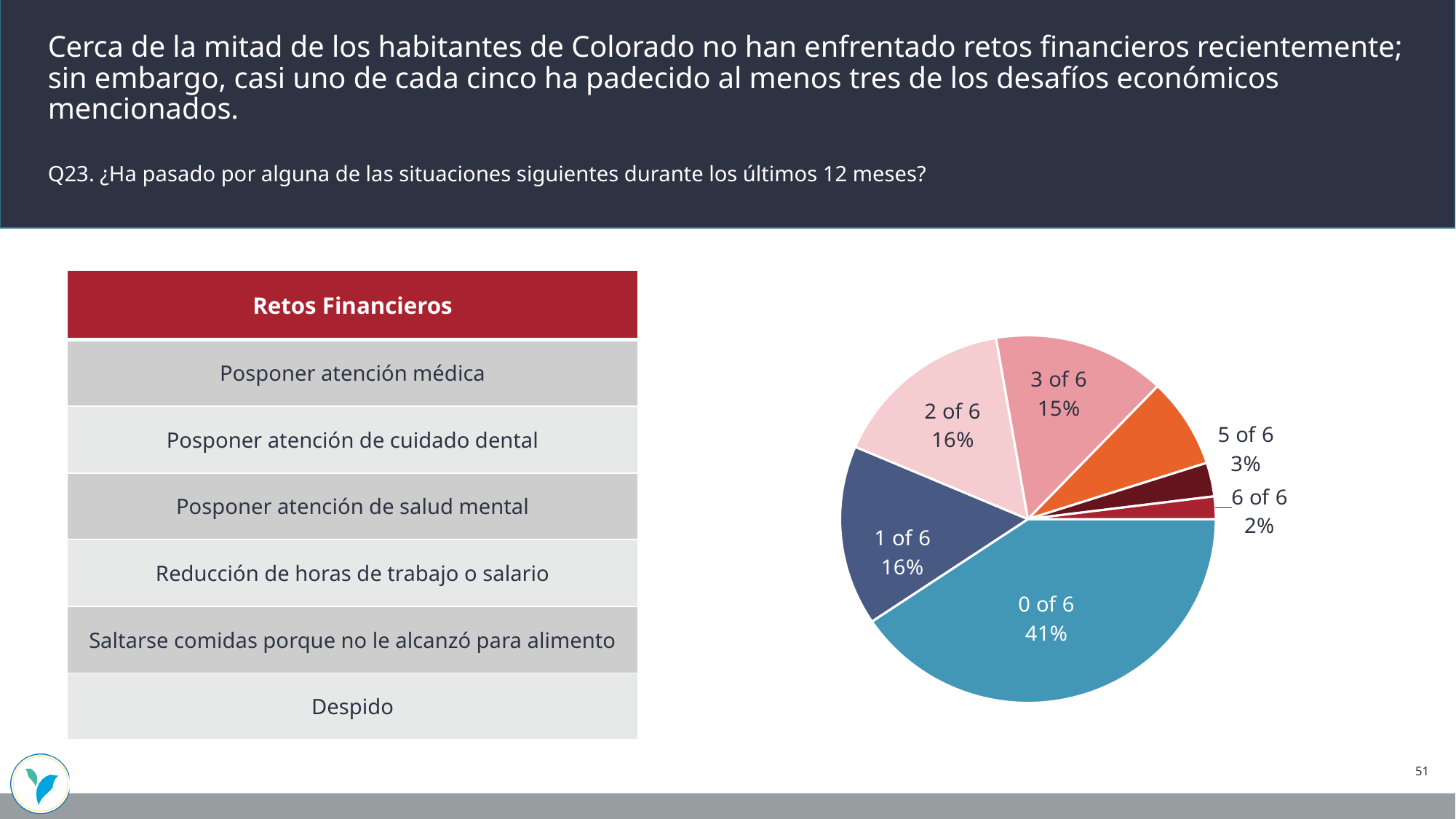
Which labeled slice of the pie chart has the smallest percentage? 6 of 6 What percentage is shown for the "6 of 6" slice? 2% What is the difference in percentage points between the "0 of 6" slice and the "3 of 6" slice? 26 percentage points Which slice is larger, "3 of 6" or "5 of 6"? 3 of 6 What percentage is shown for the "3 of 6" slice? 15% What percentage is shown for the "5 of 6" slice? 3% What percentage of the pie chart is the "0 of 6" slice? 41% Which slice of the pie chart is the largest? 0 of 6 What percentage is shown for the "1 of 6" slice? 16% What is the heading of the table to the left of the pie chart? Retos Financieros How many slices does the pie chart have? 7 What kind of chart is shown on the slide? Pie chart